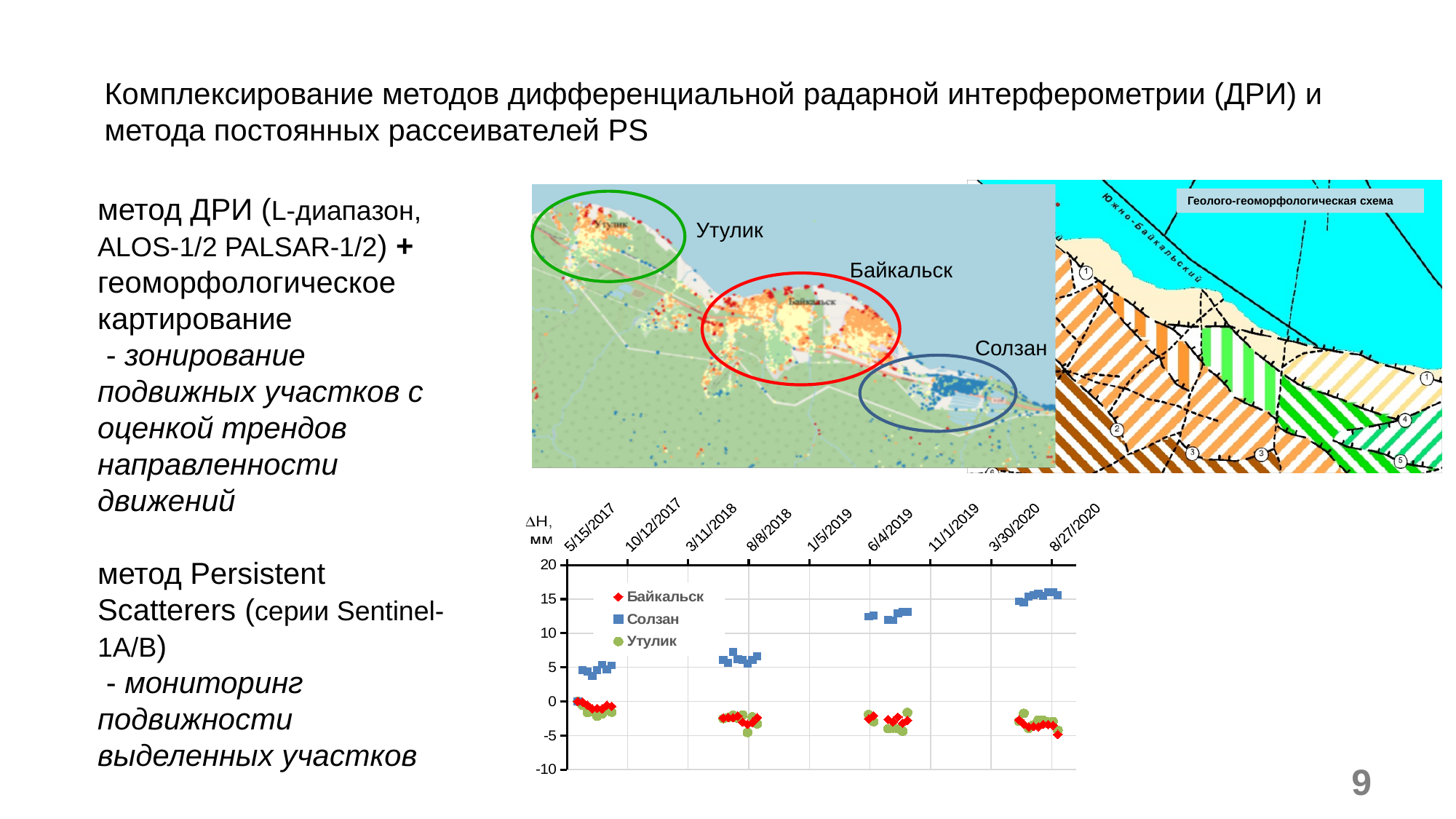
What is the label of the vertical axis of the chart? ΔH, мм Around 3/30/2020, are the values for Байкальск greater or less than 0? less How many date labels are shown along the x axis of the chart? 9 Which series has the highest values on the chart? Солзан How many series does the legend of the chart list? 3 Around 5/15/2017, are the values for Солзан greater or less than 10? less Around 8/27/2020, are the values for Солзан greater or less than 10? greater Around 6/4/2019, which series has larger values, Солзан or Утулик? Солзан What kind of chart is shown at the bottom of the slide? scatter chart Do the values for the Солзан series rise or fall from 2017 to 2020? rise Which series are listed in the chart legend? Байкальск, Солзан, Утулик